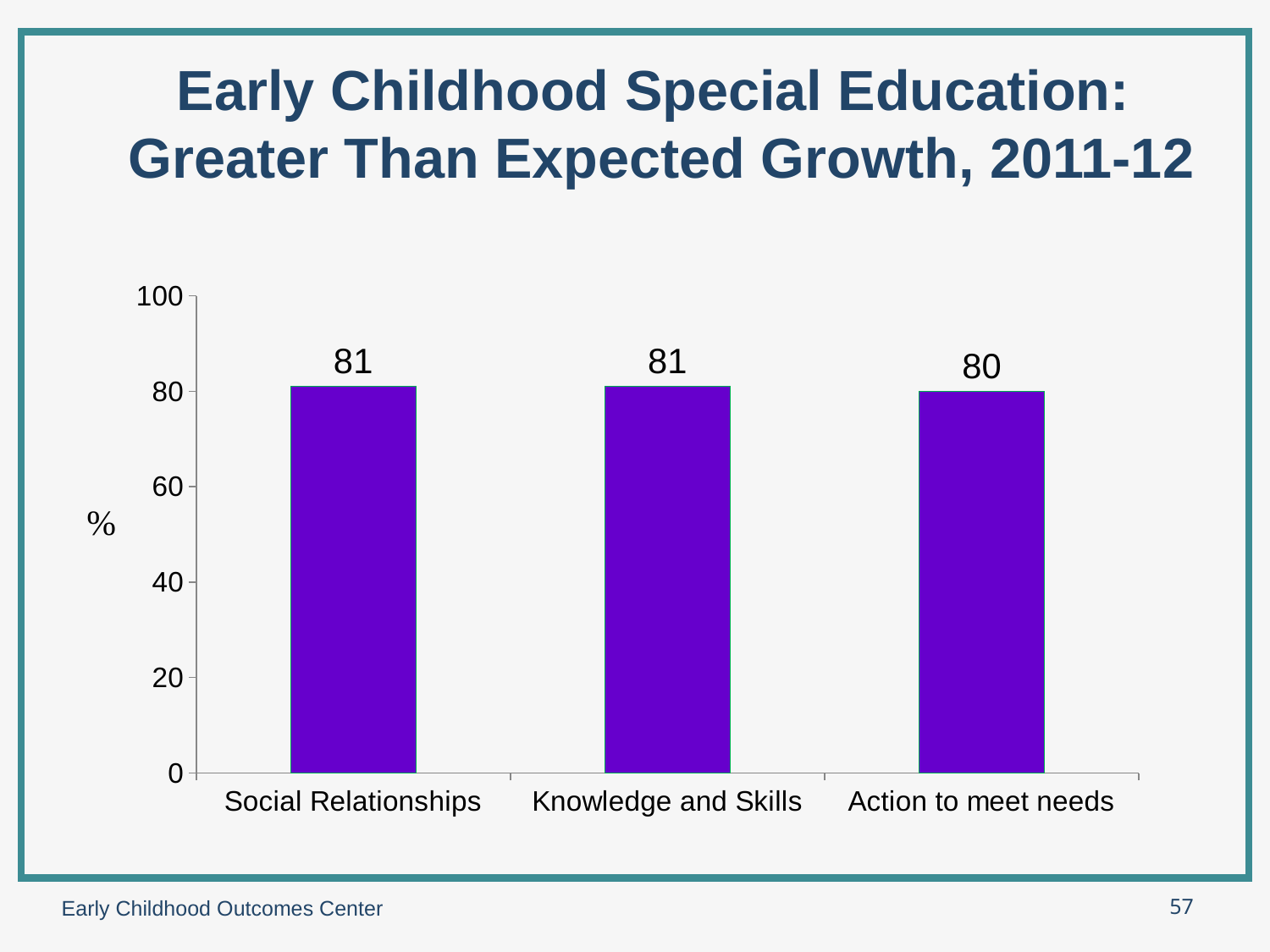
What is the value for Knowledge and Skills? 81 What is the value for Social Relationships? 81 Which is larger, the value for Knowledge and Skills or the value for Action to meet needs? Knowledge and Skills How many categories are shown on the chart? 3 Which category has the lowest value? Action to meet needs What is the difference between the values for Knowledge and Skills and Action to meet needs? 1 What is the difference between the values for Social Relationships and Action to meet needs? 1 What kind of chart is shown on the slide? bar chart Is the value for Action to meet needs greater or less than 60? greater What is the label on the vertical axis? % What is the value for Action to meet needs? 80 What is the title of the chart? Early Childhood Special Education: Greater Than Expected Growth, 2011-12